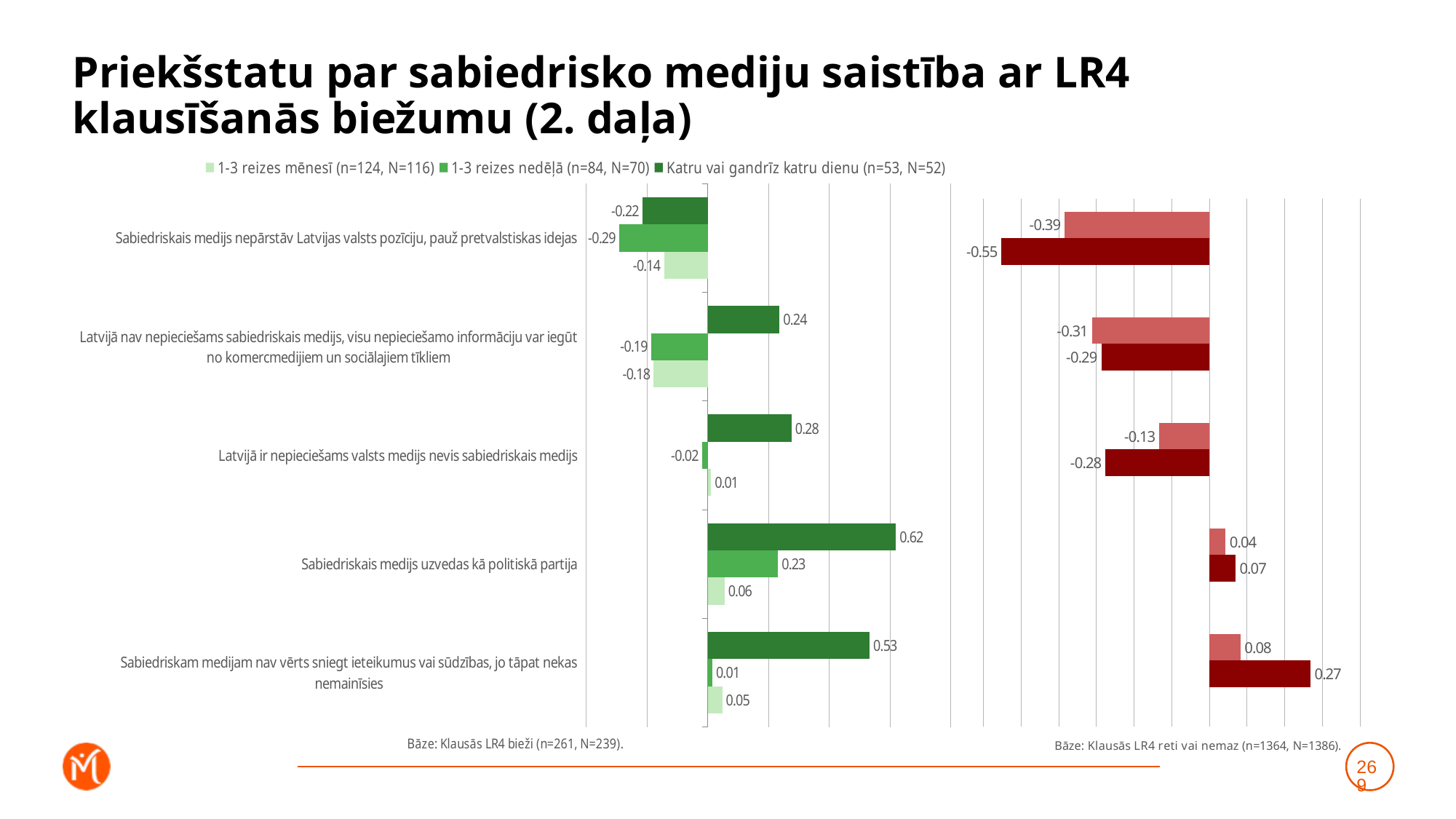
In the left chart (Bāze: Klausās LR4 bieži), what is the difference between the 'Katru vai gandrīz katru dienu' value and the '1-3 reizes nedēļā' value for 'Sabiedriskais medijs uzvedas kā politiskā partija'? 0.39 How many statements (categories) are shown in the left chart (Bāze: Klausās LR4 bieži)? 5 In the left chart (Bāze: Klausās LR4 bieži), which statement has the highest value for 'Katru vai gandrīz katru dienu'? Sabiedriskais medijs uzvedas kā politiskā partija In the left chart (Bāze: Klausās LR4 bieži), what is the value for '1-3 reizes mēnesī' for 'Latvijā nav nepieciešams sabiedriskais medijs, visu nepieciešamo informāciju var iegūt no komercmedijiem un sociālajiem tīkliem'? -0.18 In the left chart (Bāze: Klausās LR4 bieži), what is the value for 'Katru vai gandrīz katru dienu' for 'Sabiedriskais medijs uzvedas kā politiskā partija'? 0.62 What kind of chart is the left chart (Bāze: Klausās LR4 bieži)? Bar chart In the right chart (Bāze: Klausās LR4 reti vai nemaz), what is the value of the dark red bar for 'Sabiedriskam medijam nav vērts sniegt ieteikumus vai sūdzības, jo tāpat nekas nemainīsies'? 0.27 In the left chart (Bāze: Klausās LR4 bieži), what is the value for '1-3 reizes nedēļā' for 'Sabiedriskais medijs nepārstāv Latvijas valsts pozīciju, pauž pretvalstiskas idejas'? -0.29 How many series does the legend of the left chart (Bāze: Klausās LR4 bieži) list? 3 In the left chart (Bāze: Klausās LR4 bieži), which statement has the lowest value for '1-3 reizes nedēļā'? Sabiedriskais medijs nepārstāv Latvijas valsts pozīciju, pauž pretvalstiskas idejas In the left chart (Bāze: Klausās LR4 bieži), which is larger for 'Sabiedriskam medijam nav vērts sniegt ieteikumus vai sūdzības, jo tāpat nekas nemainīsies': the '1-3 reizes mēnesī' value or the '1-3 reizes nedēļā' value? 1-3 reizes mēnesī In the right chart (Bāze: Klausās LR4 reti vai nemaz), what is the value of the dark red bar for 'Sabiedriskais medijs nepārstāv Latvijas valsts pozīciju, pauž pretvalstiskas idejas'? -0.55